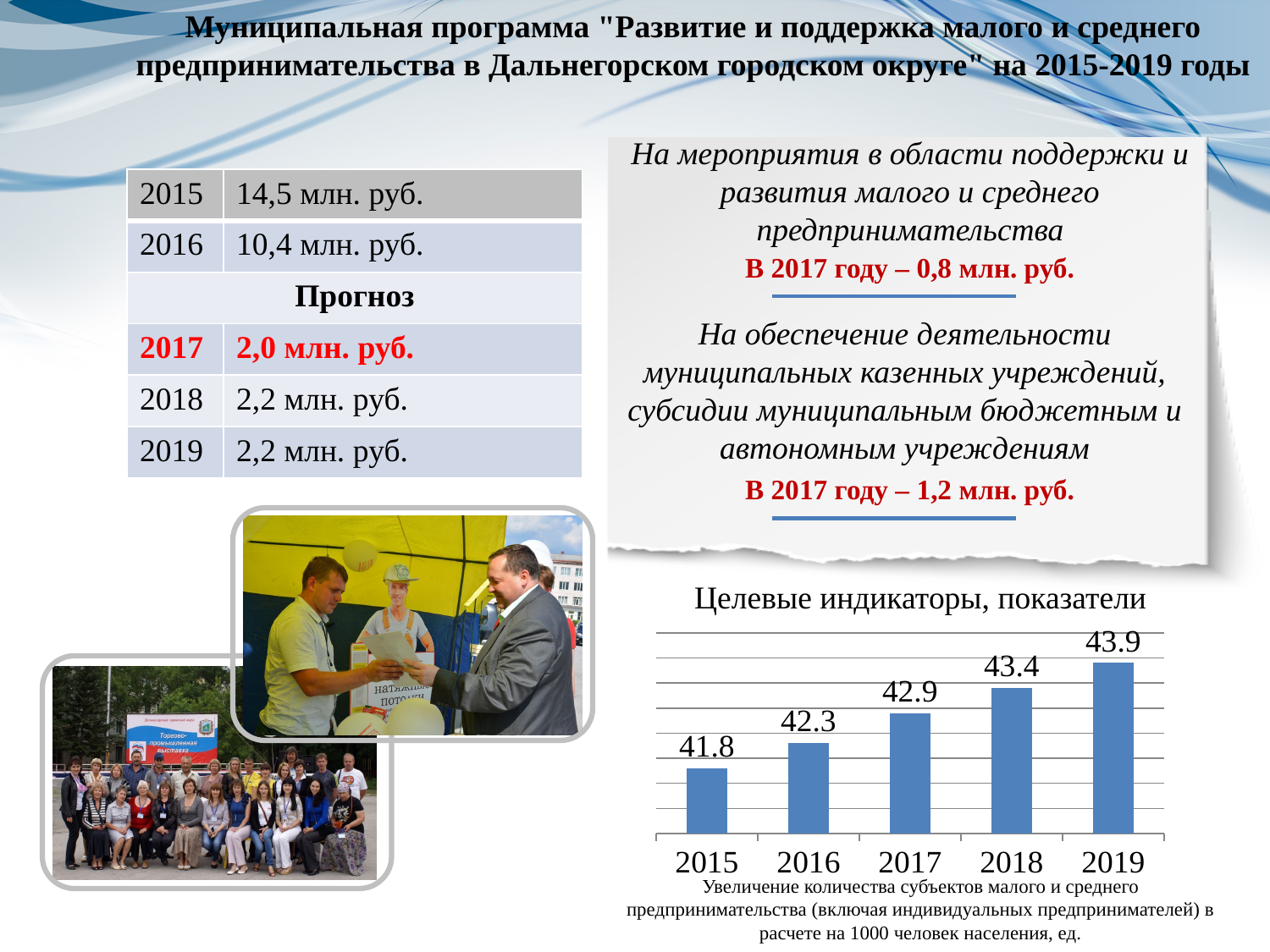
In the chart titled "Целевые индикаторы, показатели", which is larger, the value for 2016 or the value for 2018? 2018 What kind of chart is the chart titled "Целевые индикаторы, показатели"? bar chart How many years are shown on the x axis of the chart titled "Целевые индикаторы, показатели"? 5 Which year has the highest value in the chart titled "Целевые индикаторы, показатели"? 2019 What is the difference between the values for 2017 and 2016 in the chart titled "Целевые индикаторы, показатели"? 0.6 What is the value for 2018 in the chart titled "Целевые индикаторы, показатели"? 43.4 What is the value for 2019 in the chart titled "Целевые индикаторы, показатели"? 43.9 What is the difference between the values for 2019 and 2015 in the chart titled "Целевые индикаторы, показатели"? 2.1 Do the values in the chart titled "Целевые индикаторы, показатели" rise or fall from 2015 to 2019? rise What is the value for 2017 in the chart titled "Целевые индикаторы, показатели"? 42.9 What is the value for 2015 in the chart titled "Целевые индикаторы, показатели"? 41.8 Which year has the lowest value in the chart titled "Целевые индикаторы, показатели"? 2015